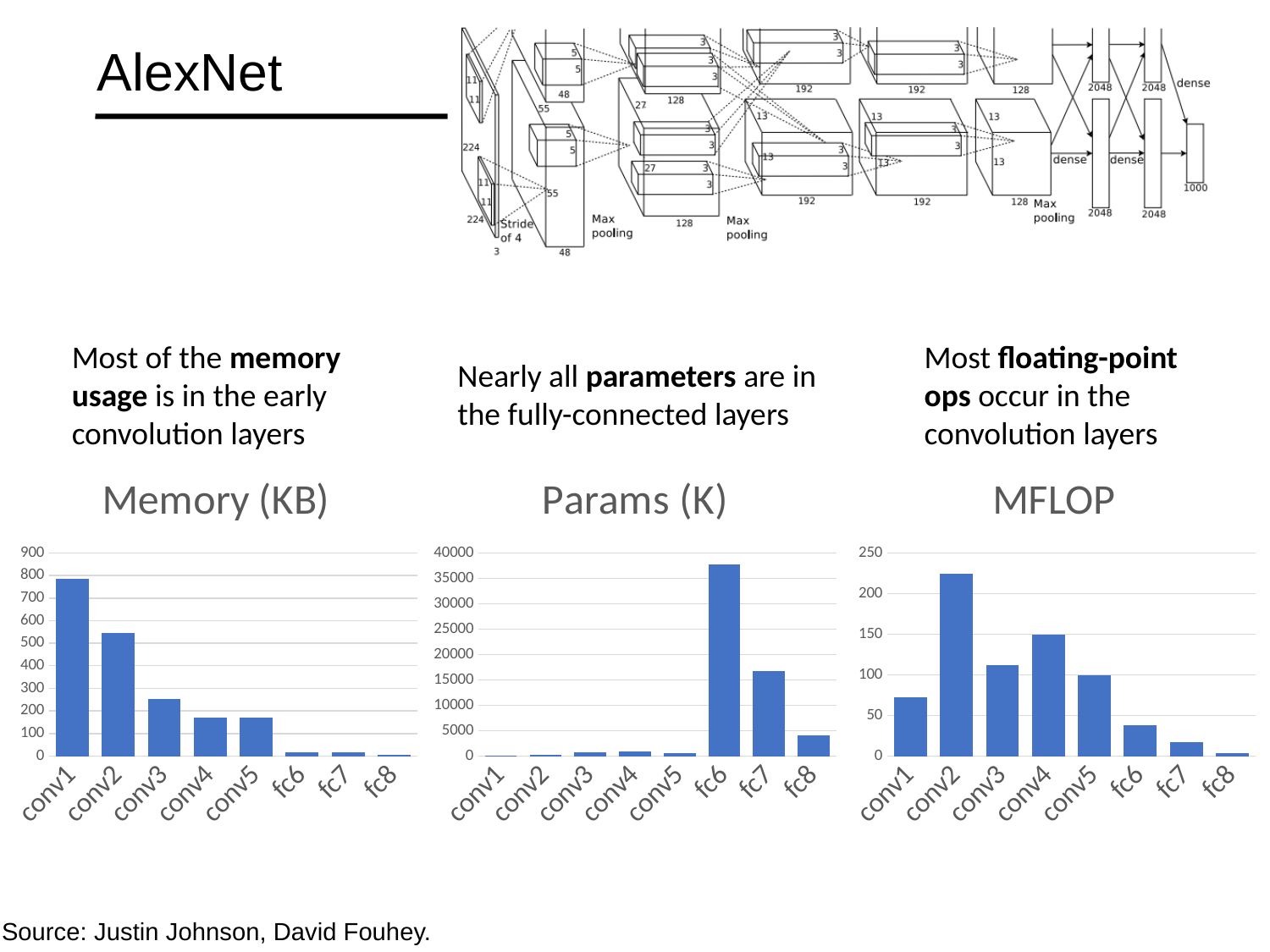
In the Memory (KB) chart, which is larger, conv2 or conv3? conv2 In the Memory (KB) chart, is the value for conv3 greater or less than 300? less In the MFLOP chart, which layer has the lowest value? fc8 In the Params (K) chart, which is larger, fc7 or fc8? fc7 In the Memory (KB) chart, is the value for conv1 greater or less than 700? greater In the MFLOP chart, which layer has the highest value? conv2 In the Params (K) chart, which layer has the most parameters? fc6 In the Memory (KB) chart, which layer has the highest memory usage? conv1 In the Params (K) chart, is the value for fc6 greater or less than 35000? greater How many layers are shown on the x axis of the MFLOP chart? 8